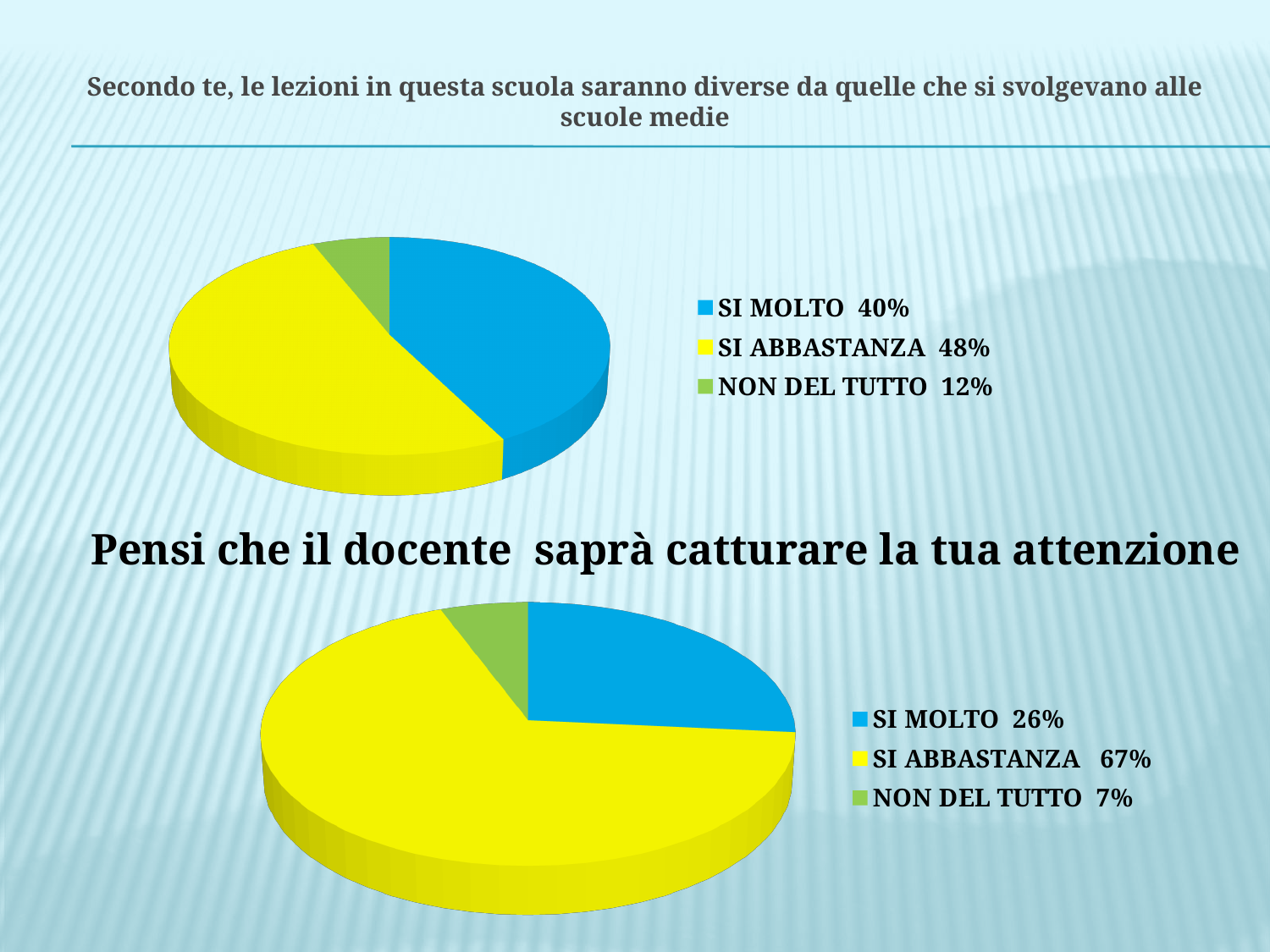
In the top pie chart (lessons different from middle school), what colour represents SI ABBASTANZA? Yellow In the top pie chart (lessons different from middle school), what share is SI MOLTO? 40% In the bottom pie chart (teacher capturing attention), what share is SI ABBASTANZA? 67% In the bottom pie chart (teacher capturing attention), what is the difference between SI ABBASTANZA and SI MOLTO? 41% In the top pie chart (lessons different from middle school), what share is NON DEL TUTTO? 12% In the bottom pie chart (teacher capturing attention), which is larger, SI MOLTO or SI ABBASTANZA? SI ABBASTANZA In the bottom pie chart (teacher capturing attention), which category has the smallest share? NON DEL TUTTO What kind of chart is the bottom chart (teacher capturing attention)? Pie chart In the top pie chart (lessons different from middle school), what is the difference between SI ABBASTANZA and SI MOLTO? 8% In the top pie chart (lessons different from middle school), how many categories does the legend list? 3 In the bottom pie chart (teacher capturing attention), what share is NON DEL TUTTO? 7% In the top pie chart (lessons different from middle school), which category has the largest share? SI ABBASTANZA